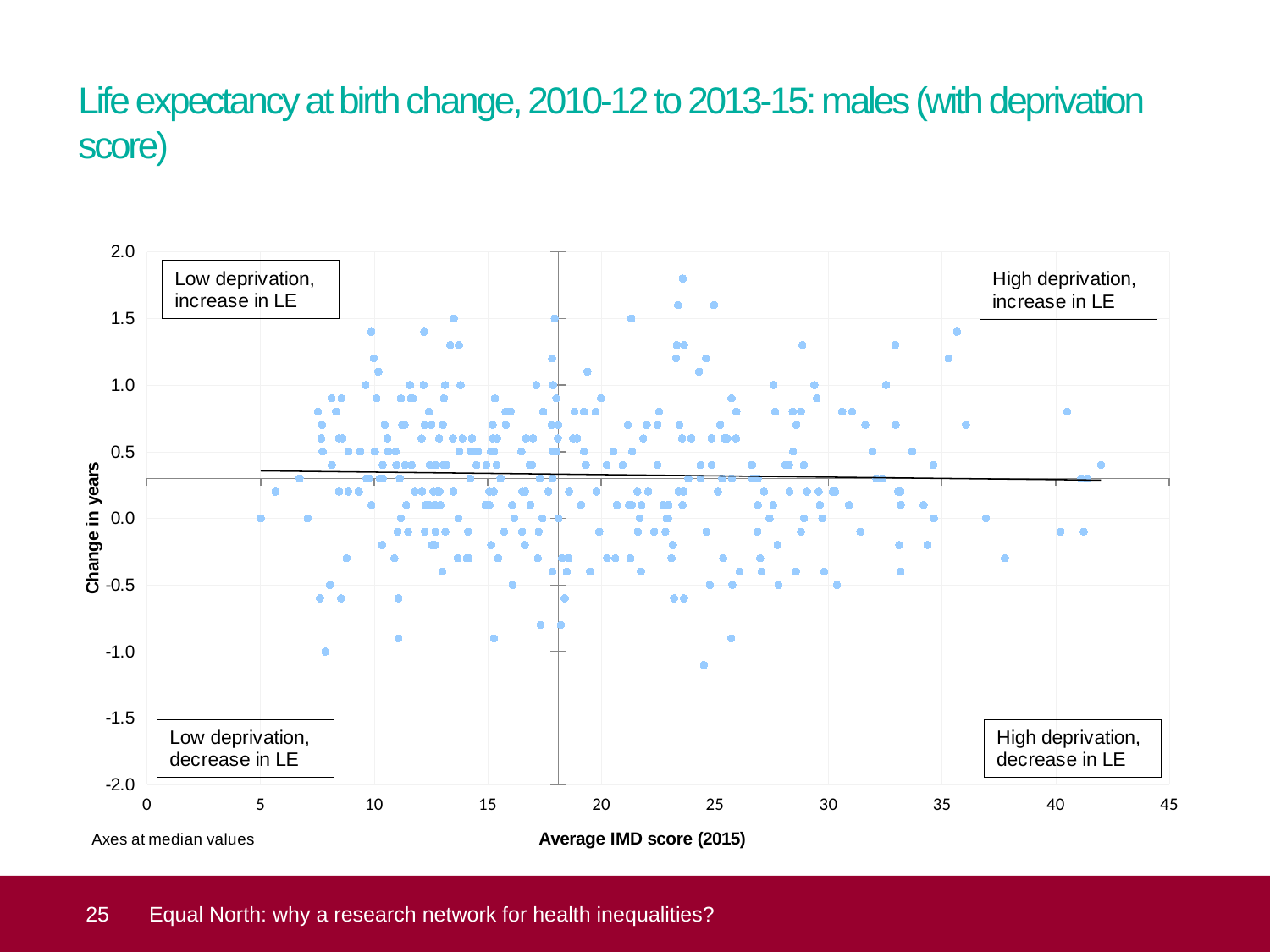
Does the fitted trend line rise or fall as Average IMD score increases? falls slightly Is the highest plotted change in life expectancy greater or less than 2.0 years? less What is the title of the horizontal axis? Average IMD score (2015) Is the highest plotted change in life expectancy greater or less than 1.5 years? greater Is the lowest plotted change in life expectancy greater or less than -1.0 years? less What kind of chart is shown on the slide? scatter chart What is the title of the vertical axis? Change in years